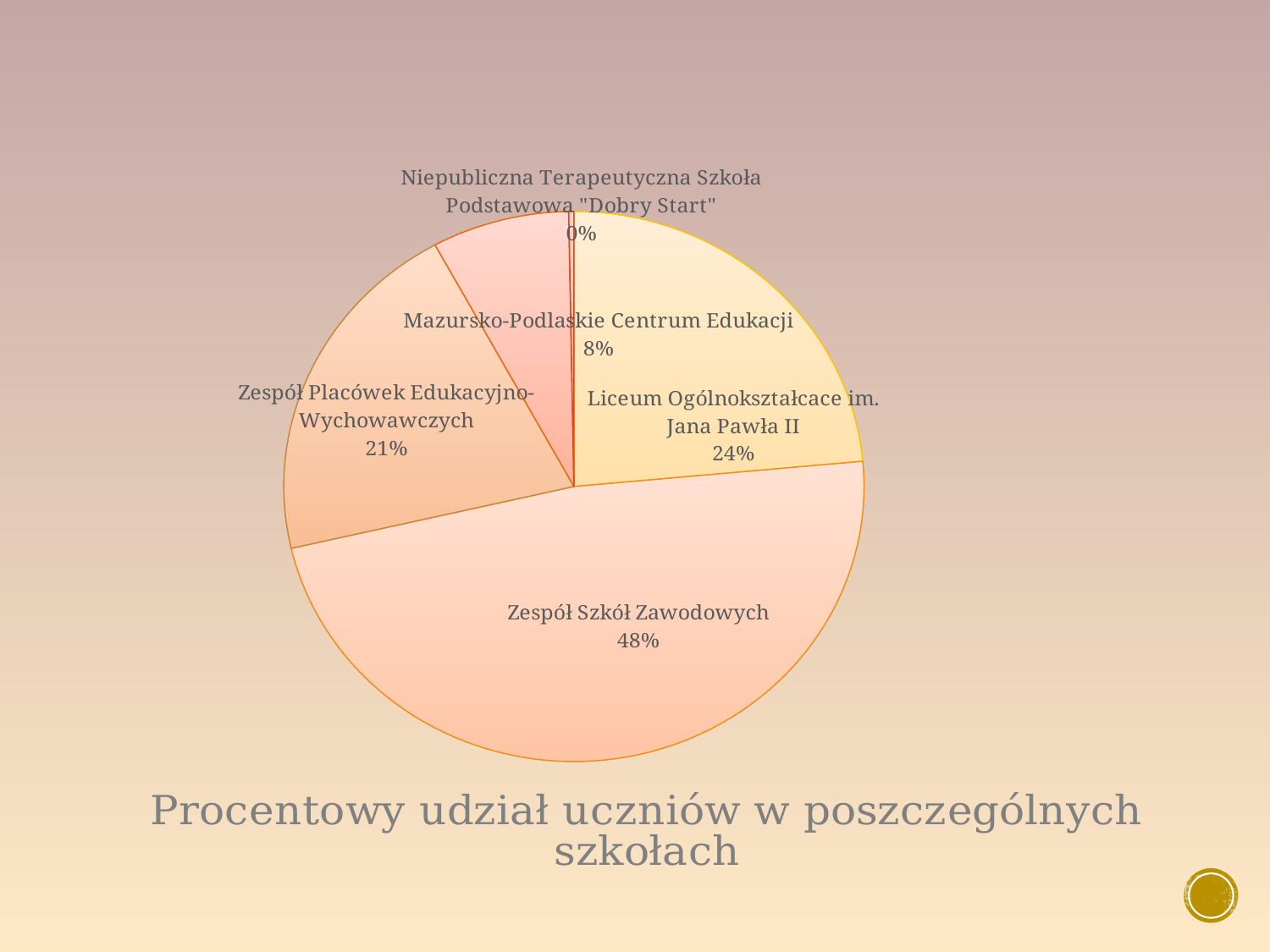
What share of students does Zespół Szkół Zawodowych have? 48% What is the difference in percentage points between Zespół Szkół Zawodowych and Liceum Ogólnokształcące im. Jana Pawła II? 24 Which school has the smallest share of students? Niepubliczna Terapeutyczna Szkoła Podstawowa "Dobry Start" What share is shown for Niepubliczna Terapeutyczna Szkoła Podstawowa "Dobry Start"? 0% Which school has the largest share of students? Zespół Szkół Zawodowych Which has a larger share, Zespół Placówek Edukacyjno-Wychowawczych or Mazursko-Podlaskie Centrum Edukacji? Zespół Placówek Edukacyjno-Wychowawczych What is the title shown below the chart? Procentowy udział uczniów w poszczególnych szkołach What share of students does Mazursko-Podlaskie Centrum Edukacji have? 8% How many slices does the pie chart have? 5 What kind of chart is shown on the slide? pie chart